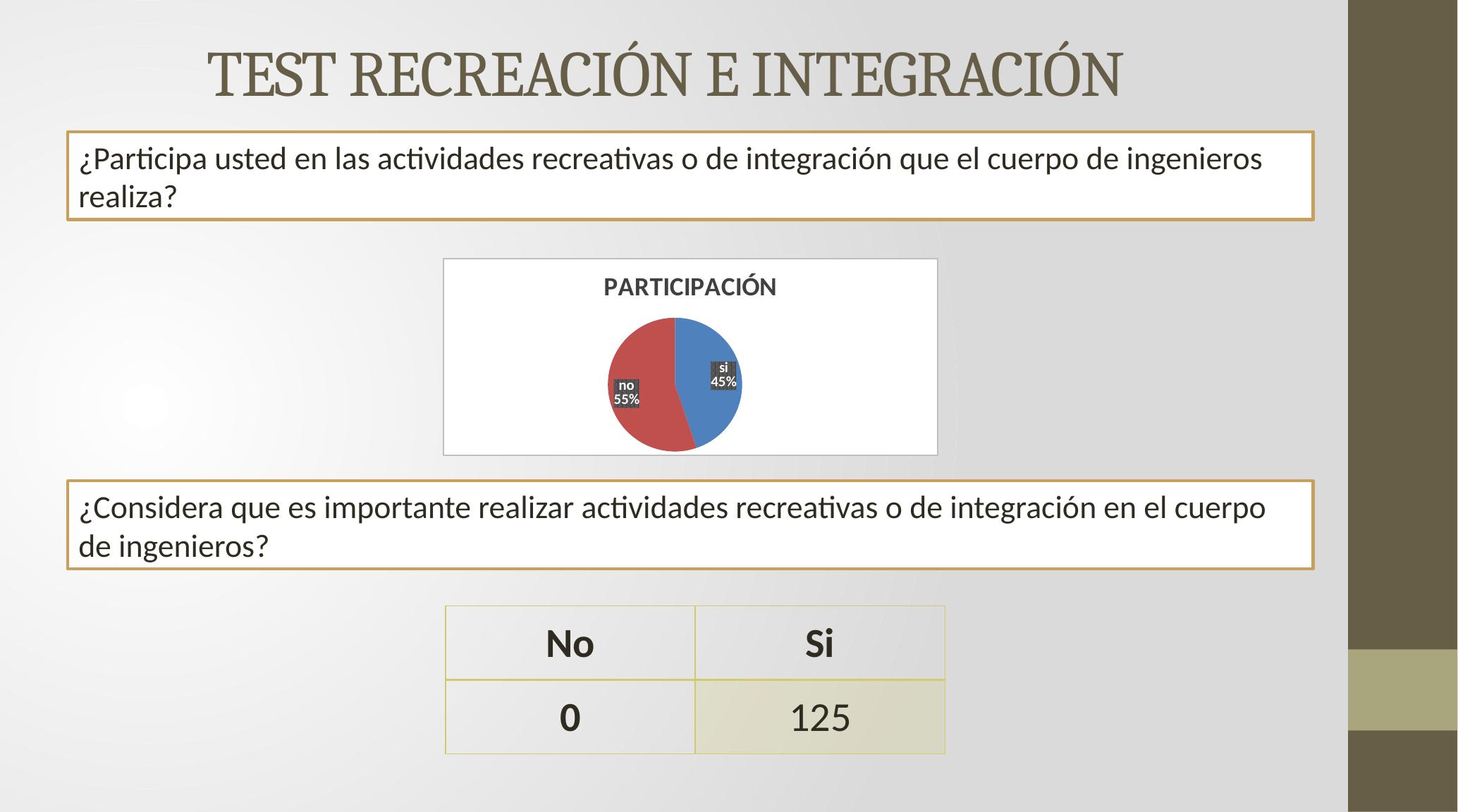
In the PARTICIPACIÓN pie chart, which is larger, the "si" slice or the "no" slice? no Which slice of the PARTICIPACIÓN pie chart is the smallest? si What is the title of the pie chart on the slide? PARTICIPACIÓN Which slice of the PARTICIPACIÓN pie chart is the largest? no In the PARTICIPACIÓN pie chart, what share of the pie is labelled "no"? 55% How many slices does the PARTICIPACIÓN pie chart have? 2 In the PARTICIPACIÓN pie chart, what is the difference in percentage points between the "no" slice and the "si" slice? 10 What kind of chart is shown under the title PARTICIPACIÓN? pie chart In the PARTICIPACIÓN pie chart, what colour is the "no" slice? red In the PARTICIPACIÓN pie chart, what share of the pie is labelled "si"? 45%